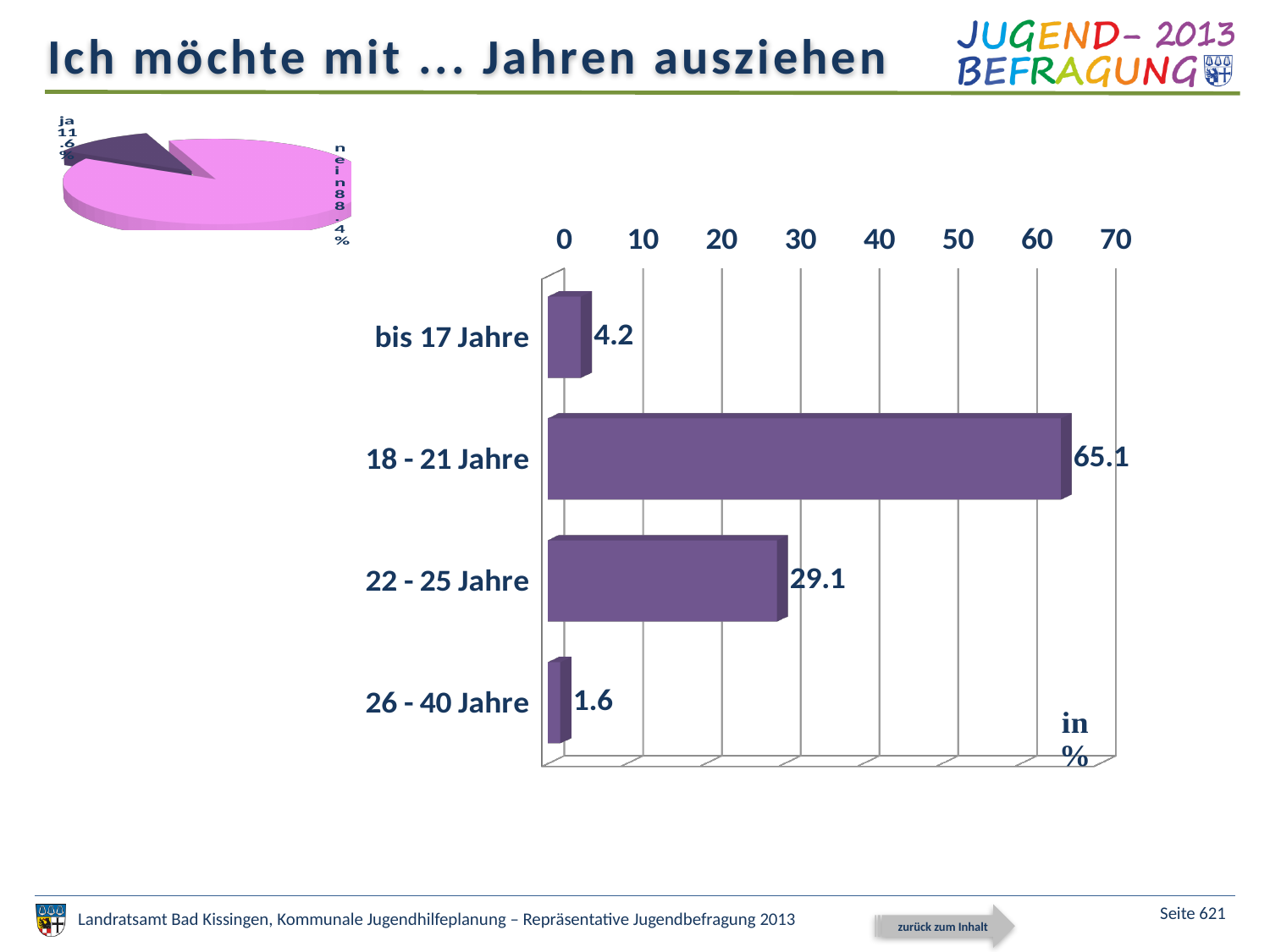
In the bar chart, is the value for 18 - 21 Jahre greater or less than 60? greater In the bar chart, which category has the lowest value? 26 - 40 Jahre What kind of chart is the large chart on the right side of the slide? bar chart In the bar chart, what is the value for 22 - 25 Jahre? 29.1 In the bar chart, which is larger: the value for bis 17 Jahre or the value for 26 - 40 Jahre? bis 17 Jahre In the bar chart, what is the value for bis 17 Jahre? 4.2 In the bar chart, what is the value for 26 - 40 Jahre? 1.6 How many categories does the bar chart show? 4 In the bar chart, what is the difference between the values for 18 - 21 Jahre and 22 - 25 Jahre? 36.0 In the pie chart at the top left, what share does the 'nein' slice have? 88.4% In the bar chart, which category has the highest value? 18 - 21 Jahre In the bar chart, what is the value for 18 - 21 Jahre? 65.1